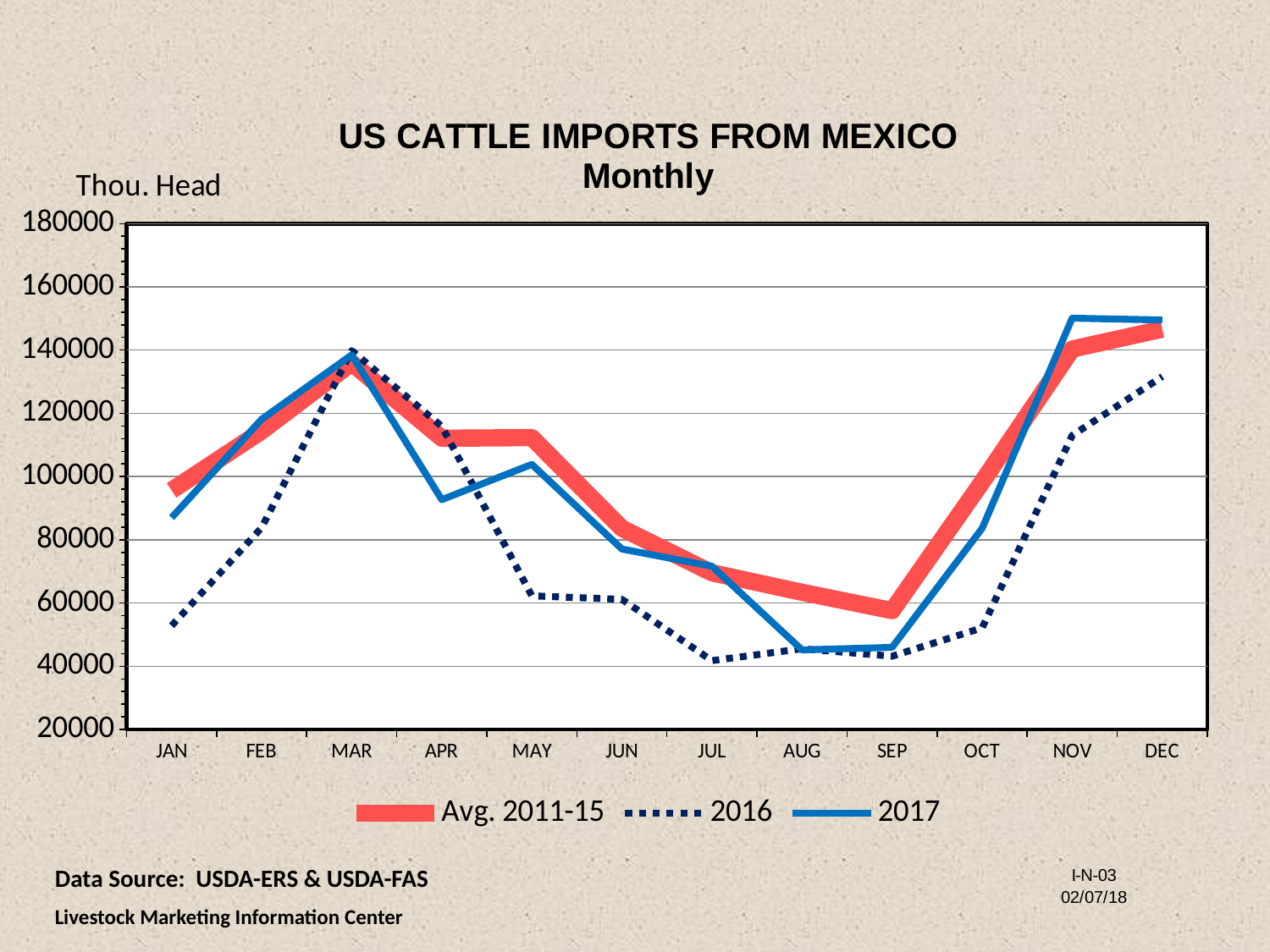
How many series does the legend list? 3 In which month does the 2016 series reach its highest value? MAR Is the 2016 value for JAN greater or less than 60000? less In JAN, which is larger: the Avg. 2011-15 value or the 2016 value? Avg. 2011-15 Does the 2016 series rise or fall from JAN to MAR? rise What kind of chart is shown on the slide? line chart In which month does the Avg. 2011-15 series reach its lowest value? SEP How many months are shown along the x axis? 12 Is the 2016 value for DEC greater or less than 120000? greater Is the 2017 value for APR greater or less than 100000? less What unit label is shown on the y axis? Thou. Head